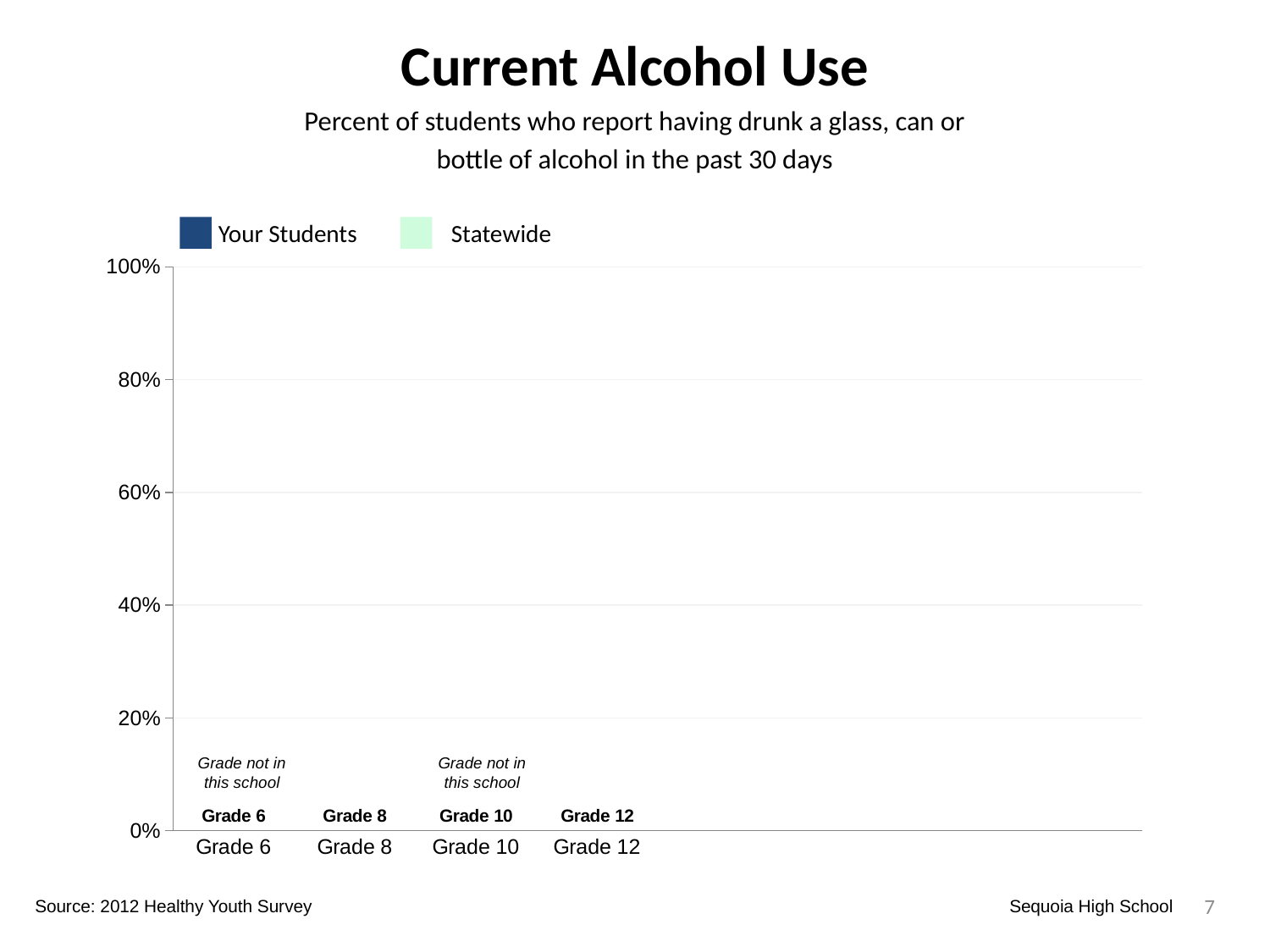
How many series does the legend list on the Current Alcohol Use chart? 2 What is the highest value shown on the y axis of the Current Alcohol Use chart? 100% Which grades on the Current Alcohol Use chart are marked 'Grade not in this school'? Grade 6 and Grade 10 How many grade categories are shown on the x axis of the Current Alcohol Use chart? 4 What are the two series named in the legend of the Current Alcohol Use chart? Your Students and Statewide What is the title of the chart on this slide? Current Alcohol Use